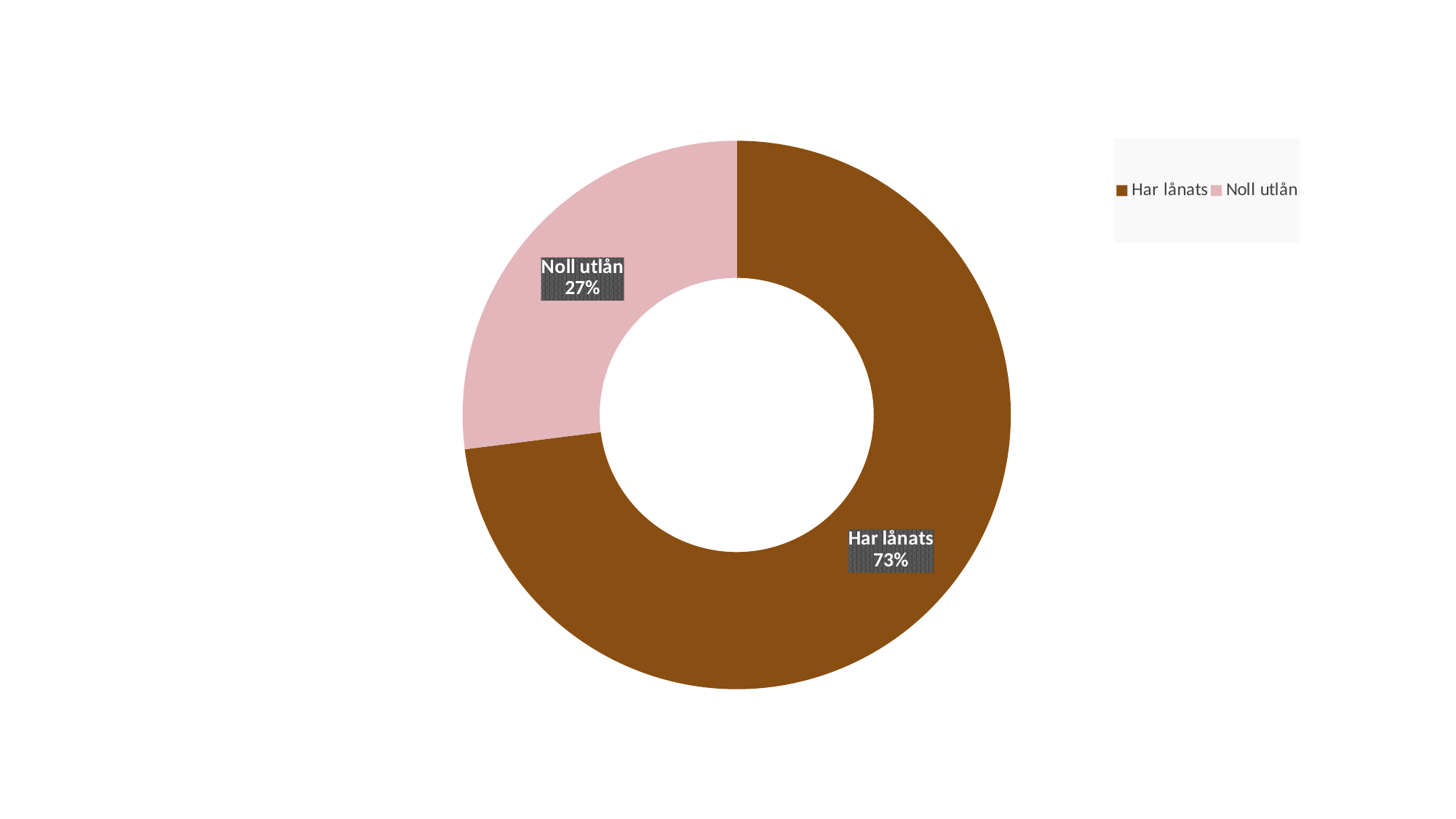
What kind of chart is shown on the slide? Doughnut (pie) chart Which slice of the chart is the smallest? Noll utlån Which is larger, the "Har lånats" slice or the "Noll utlån" slice? Har lånats What colour is the "Har lånats" slice? Brown What share of the doughnut chart is labelled "Noll utlån"? 27% What is the difference in percentage points between the "Har lånats" and "Noll utlån" slices? 46 What colour is the "Noll utlån" slice? Pink How many entries does the legend list? 2 Which slice of the chart is the largest? Har lånats What is the total of the two slice percentages shown? 100% What share of the doughnut chart is labelled "Har lånats"? 73% How many slices does the chart have? 2